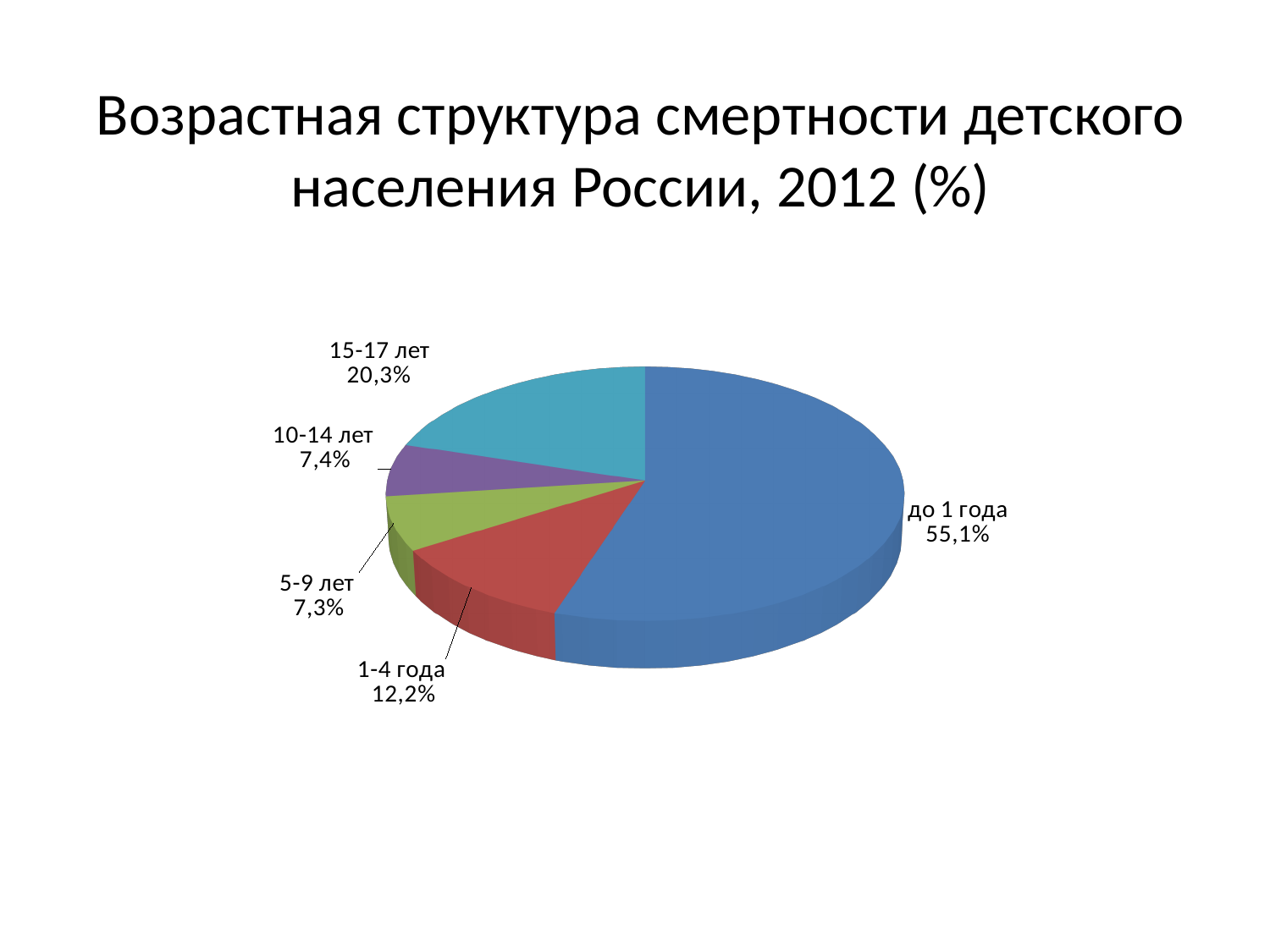
What is the difference between the "15-17 лет" slice and the "1-4 года" slice? 8,1% What is the value shown for the "10-14 лет" slice? 7,4% How many age groups are shown in the pie chart? 5 What share of the pie does the "до 1 года" slice represent? 55,1% What is the value shown for the "1-4 года" slice? 12,2% Which is larger, the slice for "15-17 лет" or the slice for "1-4 года"? 15-17 лет What type of chart is shown on the slide? Pie chart What is the value shown for the "15-17 лет" slice? 20,3% What is the difference between the "до 1 года" slice and the "15-17 лет" slice? 34,8% What is the value shown for the "5-9 лет" slice? 7,3% Which age group has the largest slice of the pie? до 1 года What is the title of the chart on the slide? Возрастная структура смертности детского населения России, 2012 (%)